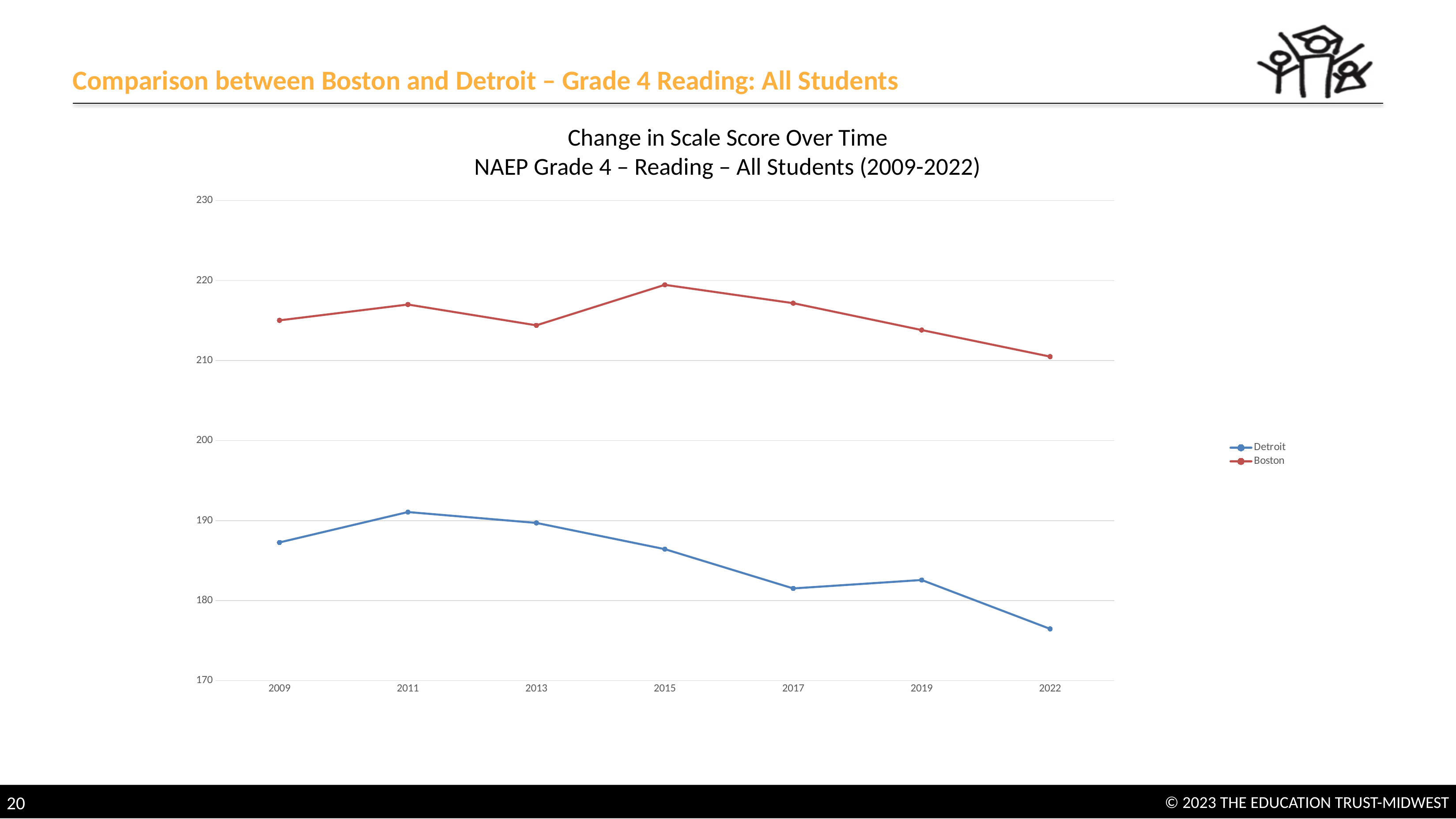
What kind of chart is shown on the slide? line chart Does the Detroit line rise or fall between 2019 and 2022? fall In which year does Boston reach its highest scale score? 2015 In which year does Detroit reach its highest scale score? 2011 Which series has the higher value in 2019, Detroit or Boston? Boston Is the value for Boston in 2015 greater or less than 210? greater How many years are plotted along the x axis? 7 In which year does Detroit have its lowest scale score? 2022 How many series does the legend list? 2 Is the value for Detroit in 2022 greater or less than 180? less Which colour is used for the Boston line? red In which year does Boston have its lowest scale score? 2022